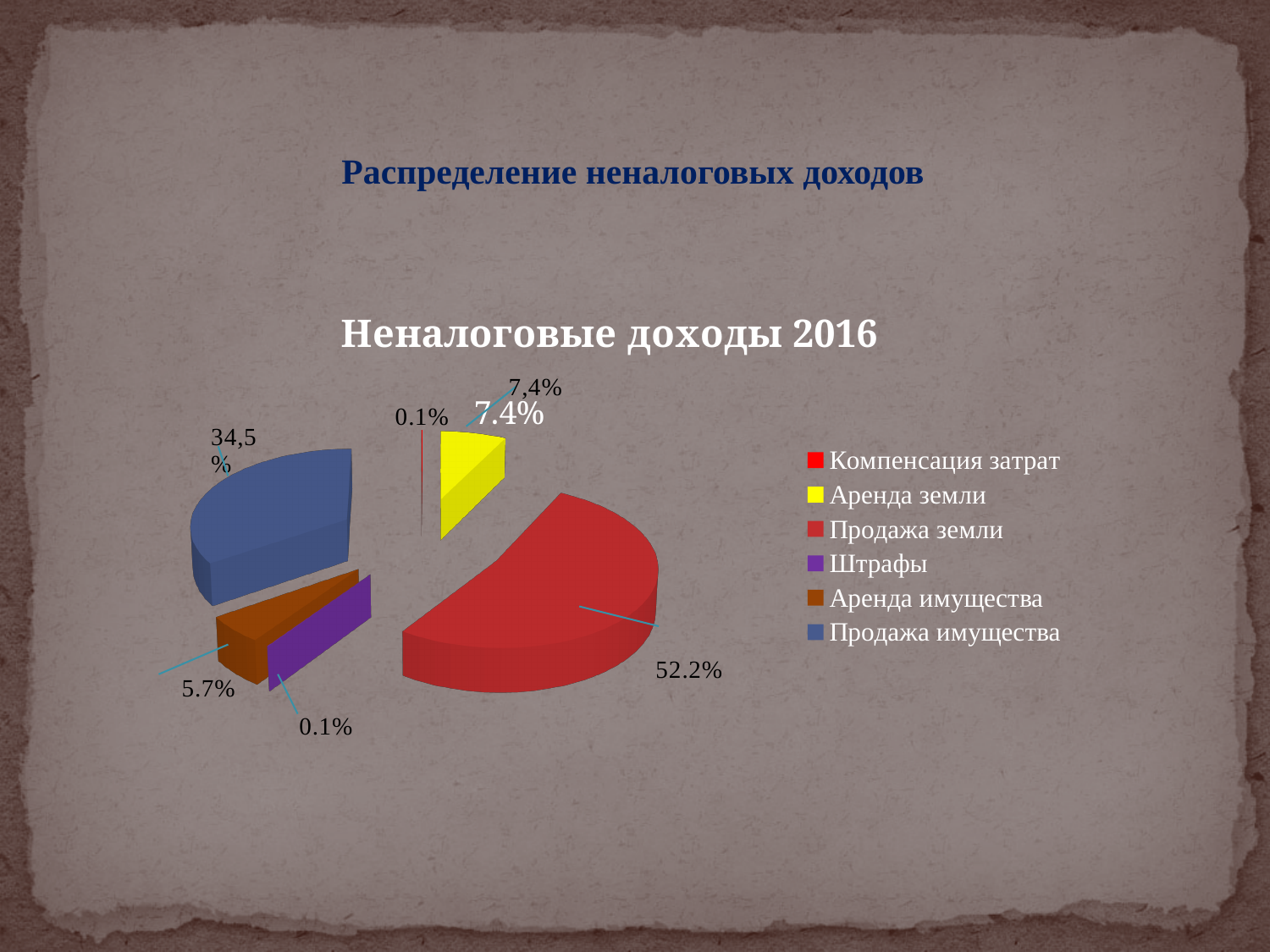
What is the title of the chart? Неналоговые доходы 2016 What is the difference between the shares of Аренда земли and Аренда имущества? 1.7% What share of the pie does Продажа земли have? 52.2% Which category has the largest slice of the pie? Продажа земли Which is larger, the slice for Продажа имущества or the slice for Аренда земли? Продажа имущества How many categories does the legend of the pie chart list? 6 What share of the pie does Аренда имущества have? 5.7% What colour represents Штрафы in the pie chart? purple What share of the pie does Продажа имущества have? 34,5% What kind of chart is shown on the slide? pie chart What share of the pie does Аренда земли have? 7.4% By how many percentage points does Продажа земли exceed Продажа имущества? 17.7%